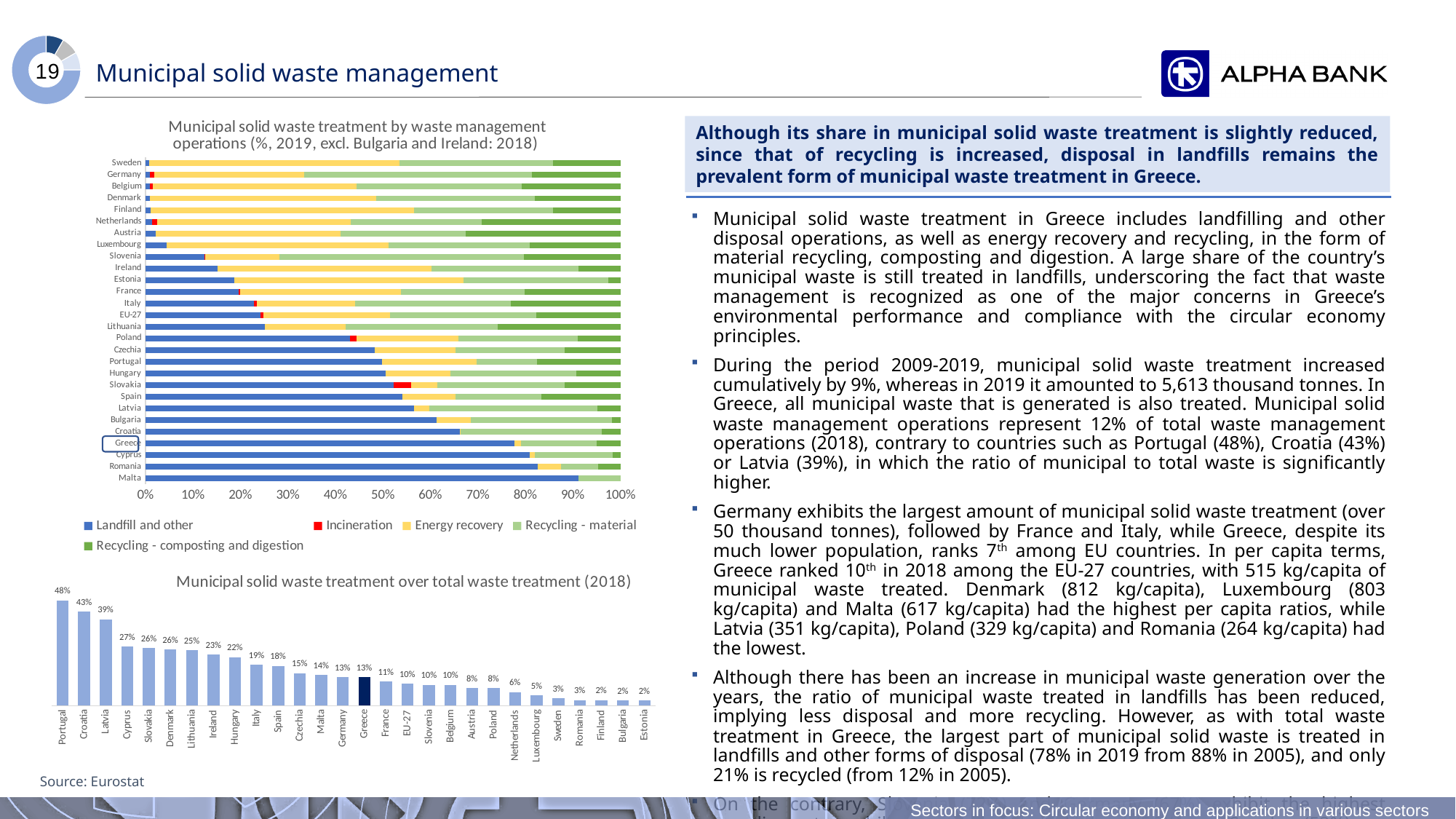
In the chart 'Municipal solid waste treatment over total waste treatment (2018)', what is the value for Portugal? 48% In the chart 'Municipal solid waste treatment over total waste treatment (2018)', what is the value for EU-27? 10% In the chart 'Municipal solid waste treatment over total waste treatment (2018)', which is larger, Cyprus or Hungary? Cyprus How many series does the legend of the top chart 'Municipal solid waste treatment by waste management operations' list? 5 In the chart 'Municipal solid waste treatment over total waste treatment (2018)', what is the difference between Croatia and Latvia? 4% In the chart 'Municipal solid waste treatment over total waste treatment (2018)', what is the value for Greece? 13% In the top chart, which series is shown in red in the legend? Incineration What kind of chart is the bottom chart on the slide? Bar chart How many bars are shown in the chart 'Municipal solid waste treatment over total waste treatment (2018)'? 28 In the top chart 'Municipal solid waste treatment by waste management operations', is the 'Landfill and other' value for Greece greater or less than 70%? greater In the top chart 'Municipal solid waste treatment by waste management operations', is the 'Landfill and other' value for Sweden greater or less than 10%? less In the chart 'Municipal solid waste treatment over total waste treatment (2018)', which country has the highest value? Portugal